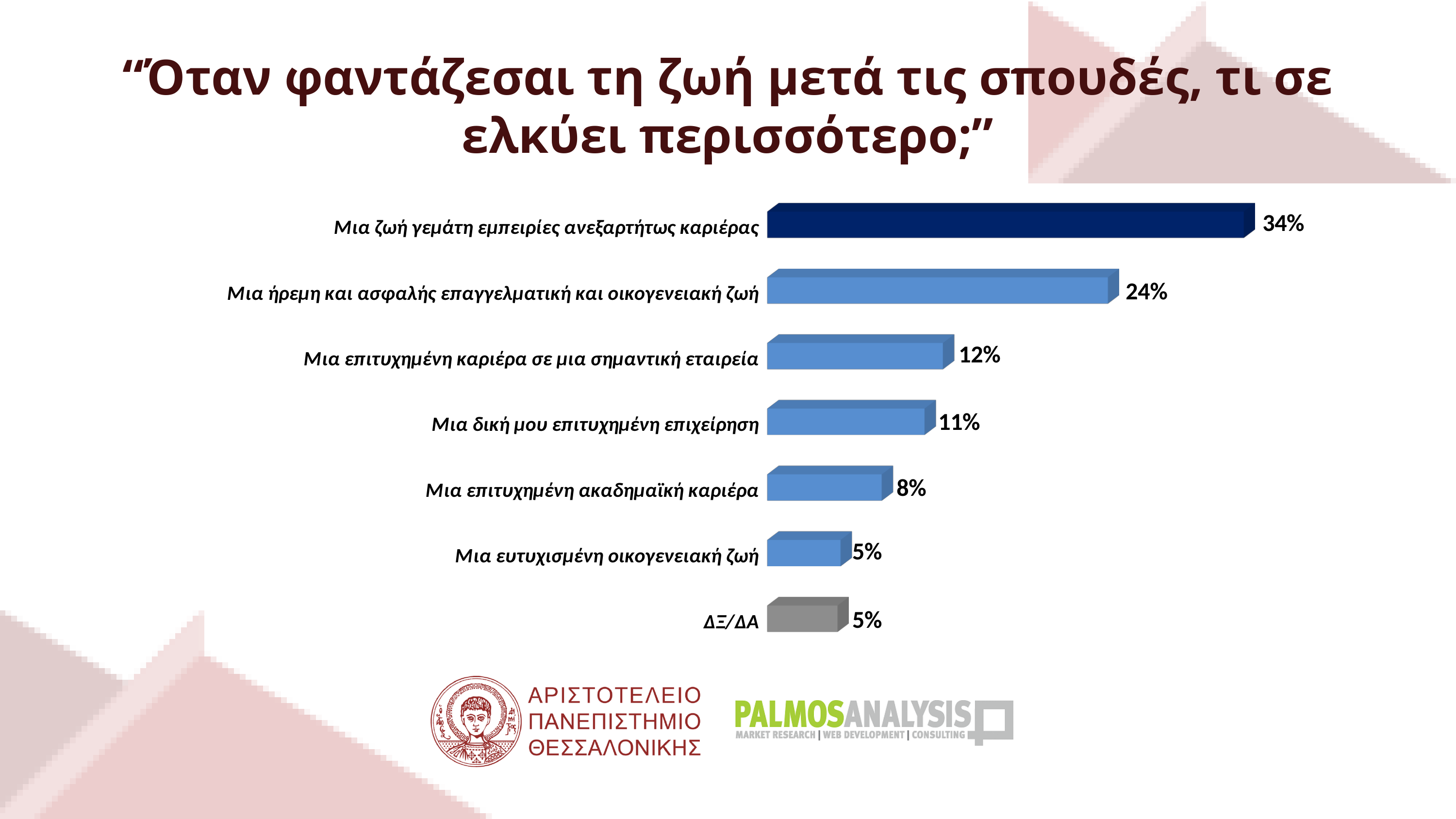
What is the difference between the values for "Μια επιτυχημένη καριέρα σε μια σημαντική εταιρεία" and "Μια επιτυχημένη ακαδημαϊκή καριέρα"? 4% What is the difference between the values for "Μια ζωή γεμάτη εμπειρίες ανεξαρτήτως καριέρας" and "Μια ήρεμη και ασφαλής επαγγελματική και οικογενειακή ζωή"? 10% Which category has the highest value? Μια ζωή γεμάτη εμπειρίες ανεξαρτήτως καριέρας Which bar is shown in a different colour (grey) from the others? ΔΞ/ΔΑ What is the value for "Μια ζωή γεμάτη εμπειρίες ανεξαρτήτως καριέρας"? 34% What kind of chart is shown on the slide? Bar chart What is the value for "Μια ήρεμη και ασφαλής επαγγελματική και οικογενειακή ζωή"? 24% What is the value for "Μια δική μου επιτυχημένη επιχείρηση"? 11% How many categories are shown in the chart? 7 What is the value for "Μια επιτυχημένη ακαδημαϊκή καριέρα"? 8% Which is larger: the value for "Μια επιτυχημένη καριέρα σε μια σημαντική εταιρεία" or "Μια δική μου επιτυχημένη επιχείρηση"? Μια επιτυχημένη καριέρα σε μια σημαντική εταιρεία What is the value for "ΔΞ/ΔΑ"? 5%